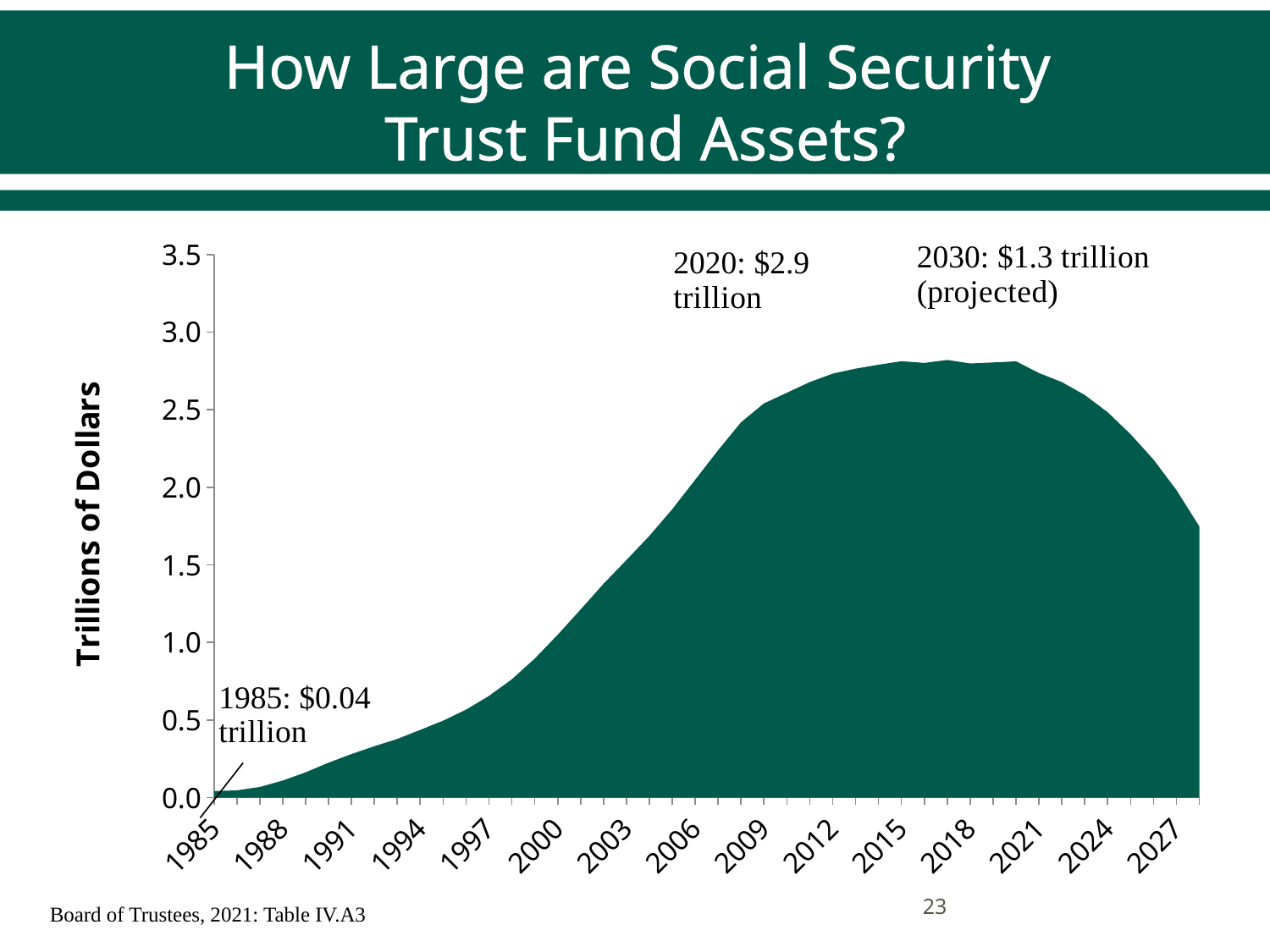
What is the difference between the annotated 2020 value and the projected 2030 value? $1.6 trillion Do the plotted values rise or fall between 2021 and 2027? fall Do the plotted values rise or fall between 1985 and 2015? rise According to the annotation, what were Social Security Trust Fund assets in 2020? $2.9 trillion Which is larger, the annotated value for 2020 or the projected value for 2030? 2020 What kind of chart is shown on the slide? area chart What is the label on the vertical axis of the chart? Trillions of Dollars According to the annotation, what were Social Security Trust Fund assets in 1985? $0.04 trillion By how much do the annotated 2020 assets exceed the annotated 1985 assets? $2.86 trillion Is the value for 1991 greater or less than 0.5 trillion dollars? less Is the value for 2012 greater or less than 2.5 trillion dollars? greater What is the projected value of Trust Fund assets for 2030 shown on the slide? $1.3 trillion (projected)